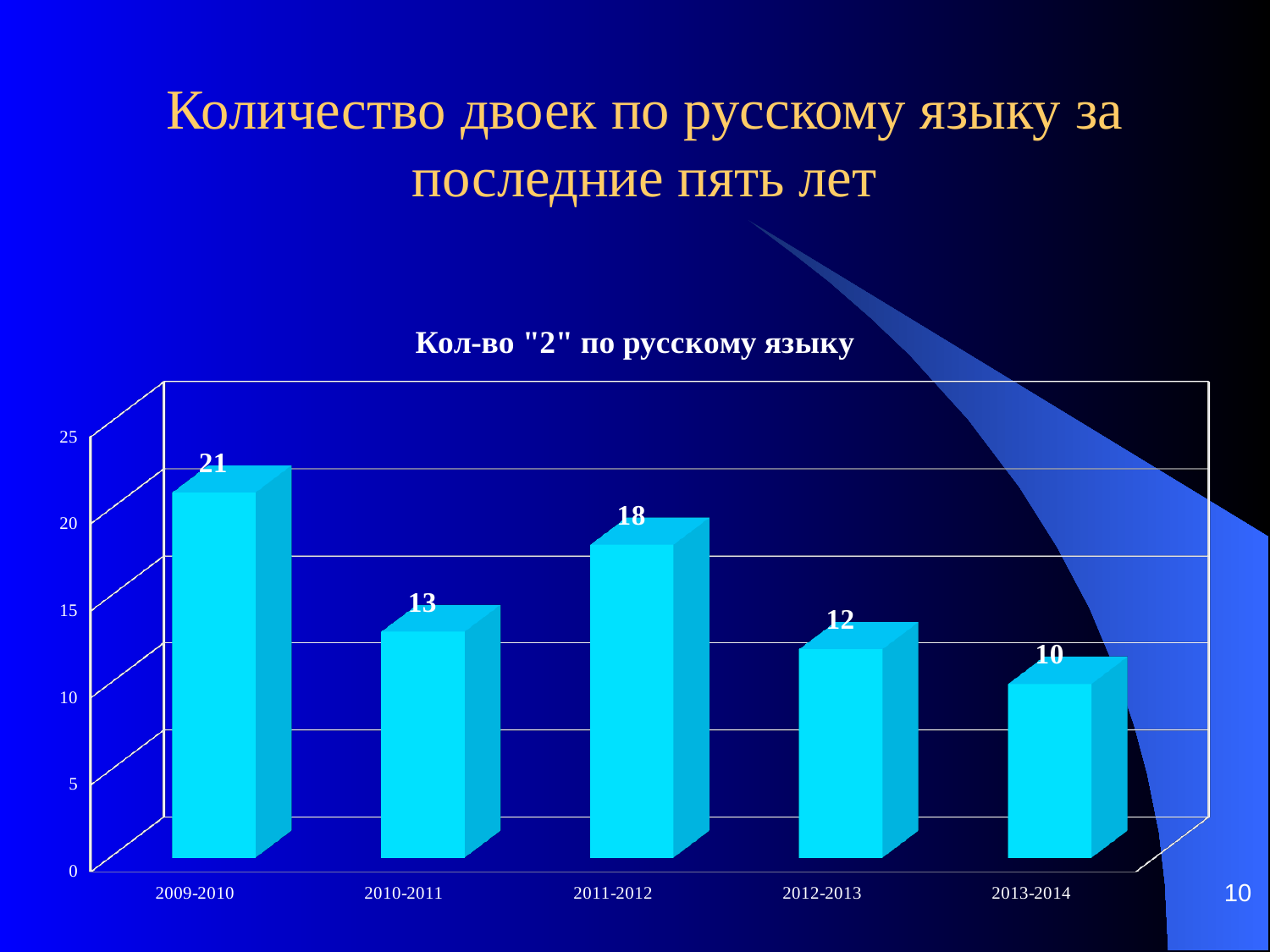
What is the value for 2013-2014? 10 How many school years are shown on the x axis? 5 What is the value for 2011-2012? 18 Which is larger, the value for 2010-2011 or the value for 2012-2013? 2010-2011 What is the value for 2009-2010? 21 What is the difference between the values for 2011-2012 and 2012-2013? 6 Is the value for 2011-2012 greater or less than 15? greater Which year has the highest number of "2" grades? 2009-2010 Which year has the lowest number of "2" grades? 2013-2014 What is the title of the chart? Кол-во "2" по русскому языку What kind of chart is shown on the slide? bar chart What is the difference between the values for 2009-2010 and 2010-2011? 8